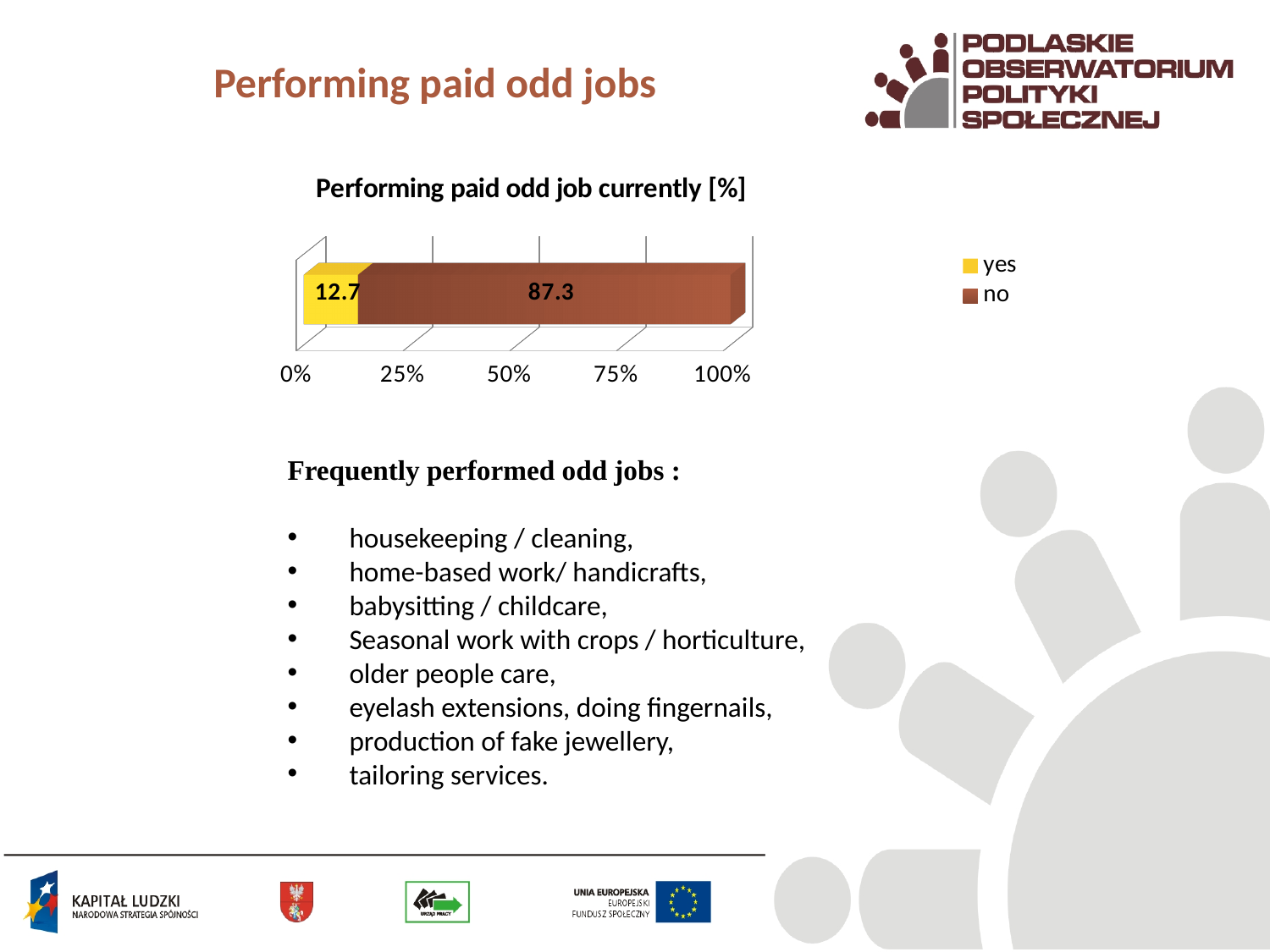
Is the value for "no" greater or less than 75%? greater What is the difference between the "no" value and the "yes" value? 74.6 What colour represents "yes" in the chart? Yellow What is the value for "no" in the chart? 87.3 Which series has the smallest value in the chart? yes What kind of chart is shown on the slide? Stacked bar chart What is the value for "yes" in the chart? 12.7 What is the title of the chart? Performing paid odd job currently [%] What is the total of the stacked bar? 100 Which series has the larger value, "yes" or "no"? no Is the value for "yes" greater or less than 25%? less How many series does the legend list? 2